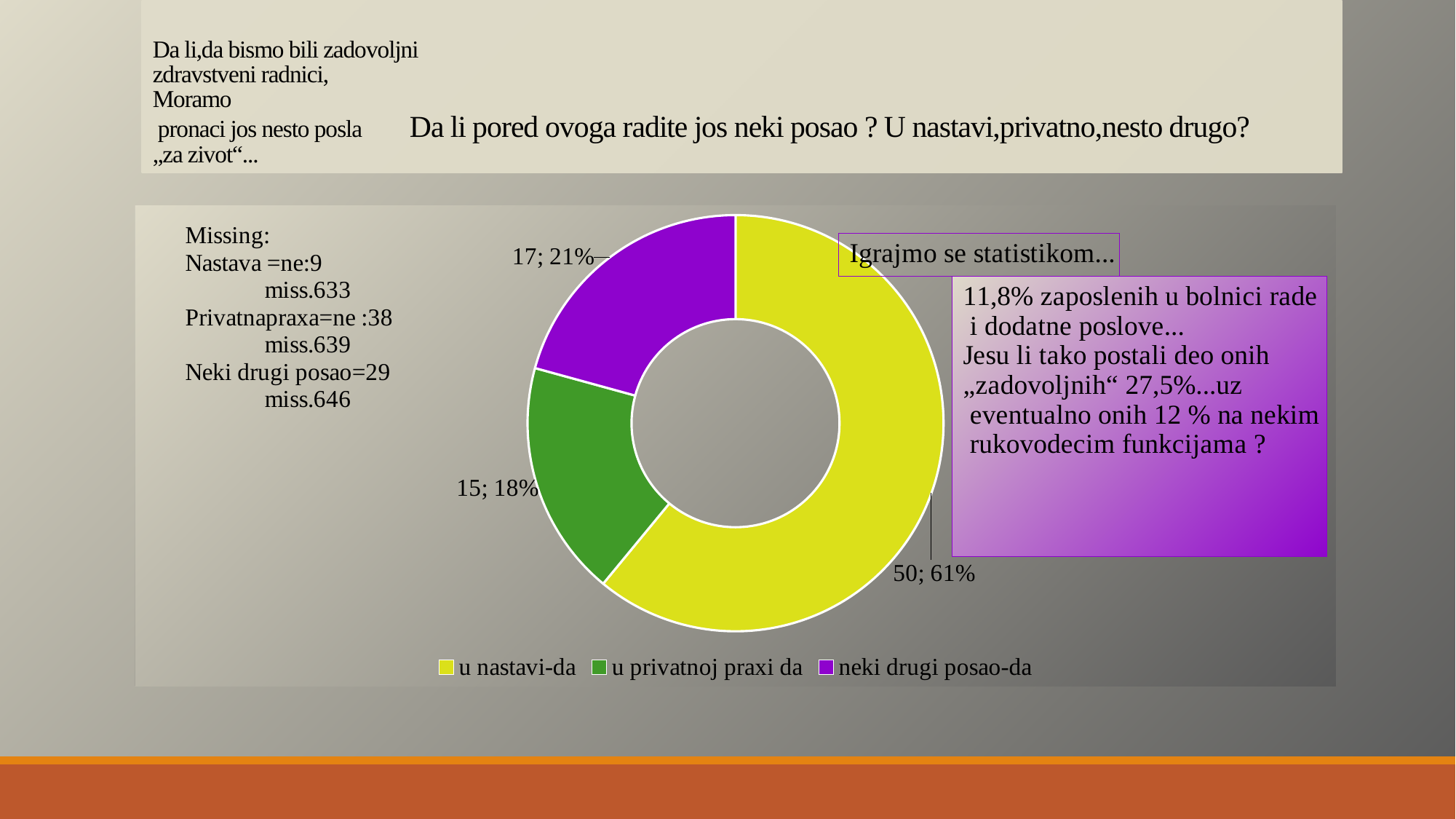
What is the value for "u nastavi-da"? 50 Which category has the smallest value? u privatnoj praxi da What share of the doughnut does "u nastavi-da" represent? 61% Which category has the largest value? u nastavi-da What is the value for "u privatnoj praxi da"? 15 What share of the doughnut does "neki drugi posao-da" represent? 21% What colour is the "u privatnoj praxi da" slice? Green What is the difference between the values for "u nastavi-da" and "neki drugi posao-da"? 33 How many categories does the doughnut chart show? 3 Which is larger, the value for "neki drugi posao-da" or "u privatnoj praxi da"? neki drugi posao-da What is the value for "neki drugi posao-da"? 17 What kind of chart is shown on the slide? Doughnut chart